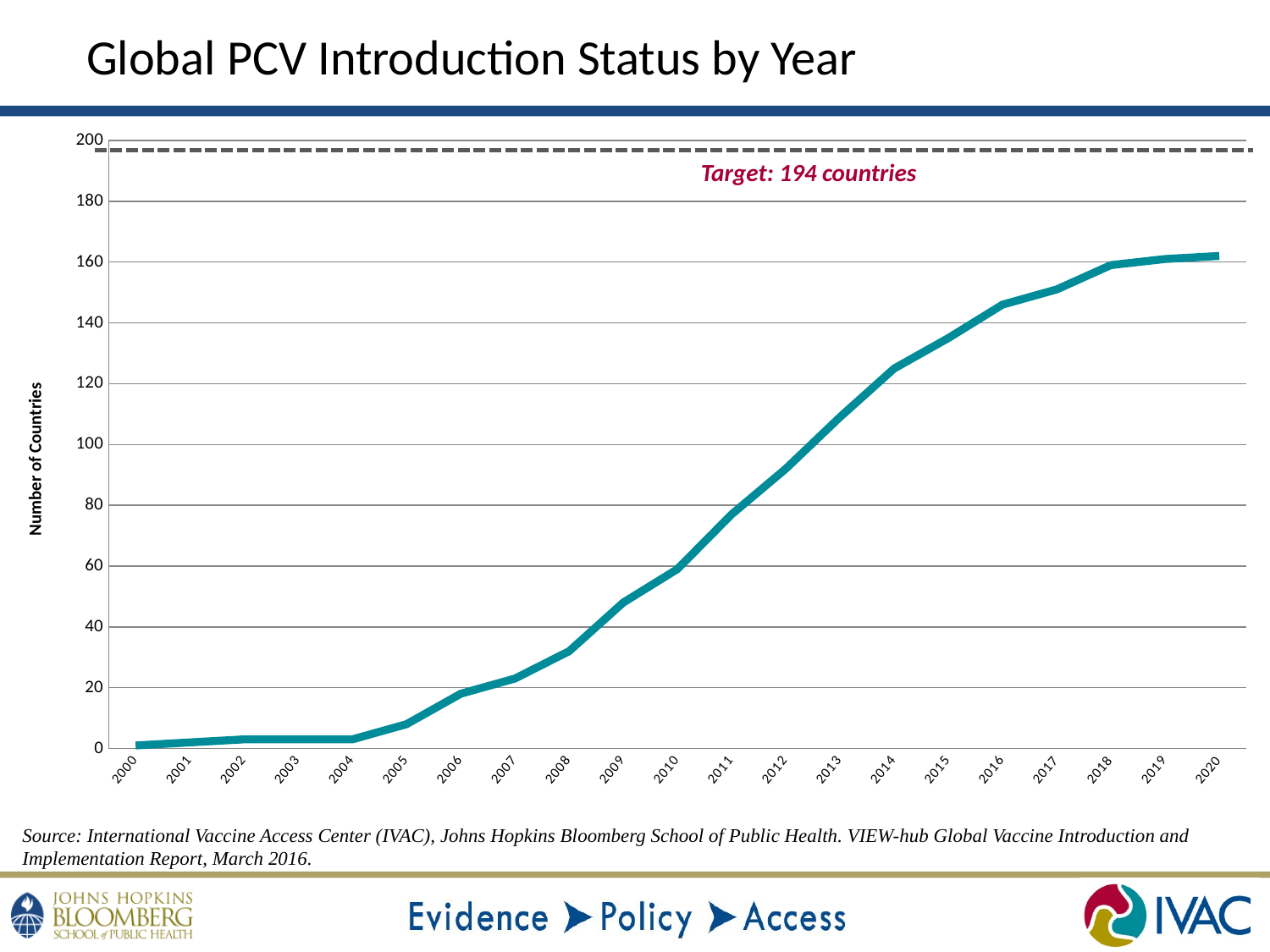
Which year has a larger value, 2009 or 2013? 2013 What kind of chart is shown on the slide? line chart What is the label on the y axis? Number of Countries How many years are plotted along the x axis? 21 Is the value for 2012 greater or less than 100? less Is the value for 2008 greater or less than 40? less Which year has the lowest number of countries? 2000 Is the value for 2014 greater or less than 120? greater Which year has the highest number of countries? 2020 Do the values rise or fall from 2000 to 2020? rise What is the target number of countries shown by the dashed line? 194 countries